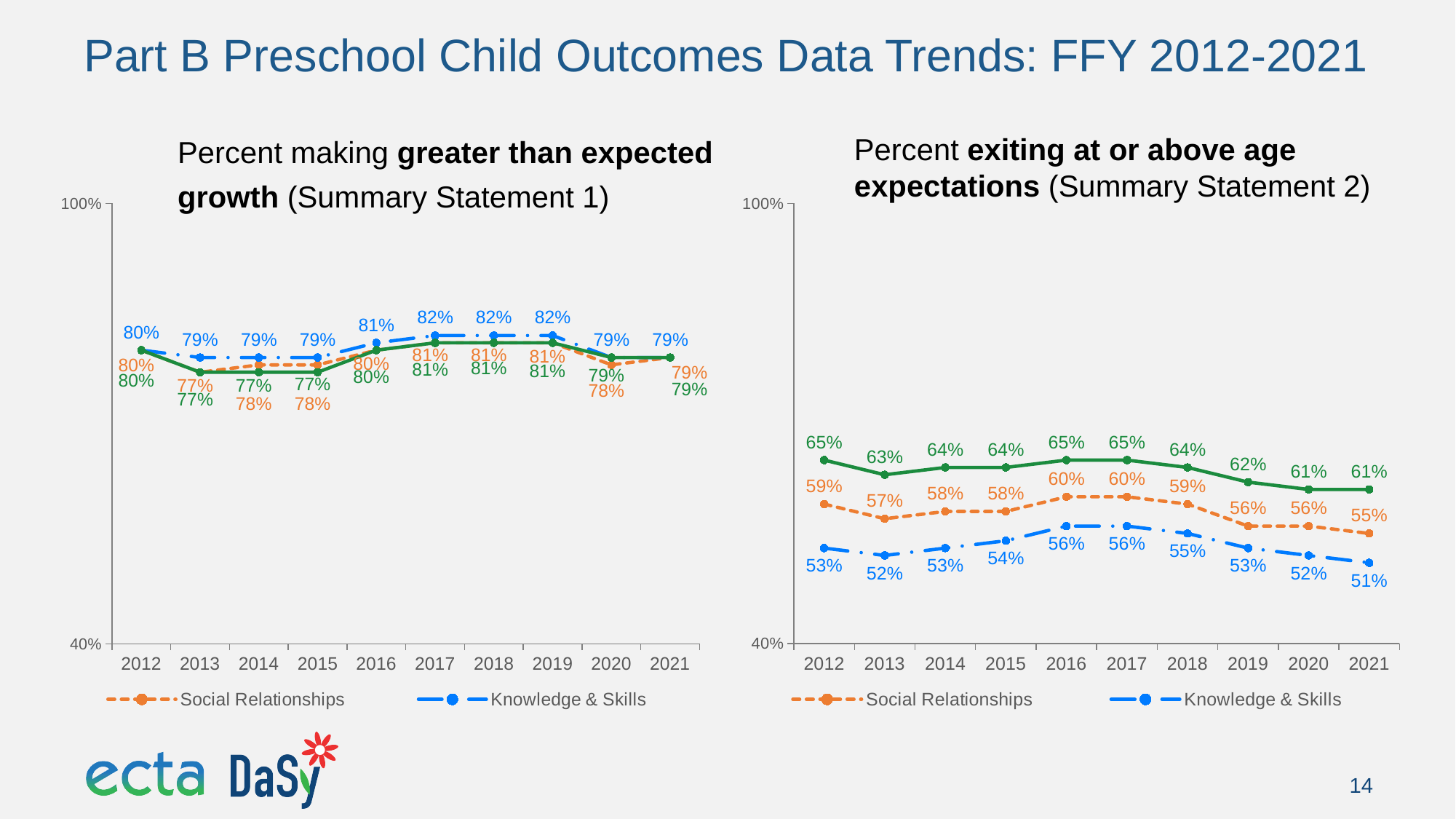
In the chart titled 'Percent exiting at or above age expectations (Summary Statement 2)', what is the Knowledge & Skills value for 2021? 51% In the chart titled 'Percent making greater than expected growth (Summary Statement 1)', what is the Knowledge & Skills value for 2017? 82% In the chart titled 'Percent exiting at or above age expectations (Summary Statement 2)', which is larger in 2019: Social Relationships or Knowledge & Skills? Social Relationships In the chart titled 'Percent making greater than expected growth (Summary Statement 1)', what is the Social Relationships value for 2013? 77% How many years are shown on the x axis of the chart titled 'Percent making greater than expected growth (Summary Statement 1)'? 10 In the chart titled 'Percent exiting at or above age expectations (Summary Statement 2)', in which year is the Knowledge & Skills value lowest? 2021 In the chart titled 'Percent exiting at or above age expectations (Summary Statement 2)', what is the Social Relationships value for 2016? 60% What kind of chart is the chart titled 'Percent making greater than expected growth (Summary Statement 1)'? Line chart In the chart titled 'Percent exiting at or above age expectations (Summary Statement 2)', does the Knowledge & Skills value rise or fall from 2017 to 2021? Fall How many series does the legend of the chart titled 'Percent exiting at or above age expectations (Summary Statement 2)' list? 2 In the chart titled 'Percent making greater than expected growth (Summary Statement 1)', in which year is the Social Relationships value lowest? 2013 In the chart titled 'Percent exiting at or above age expectations (Summary Statement 2)', what is the difference between the Social Relationships and Knowledge & Skills values in 2012? 6 percentage points